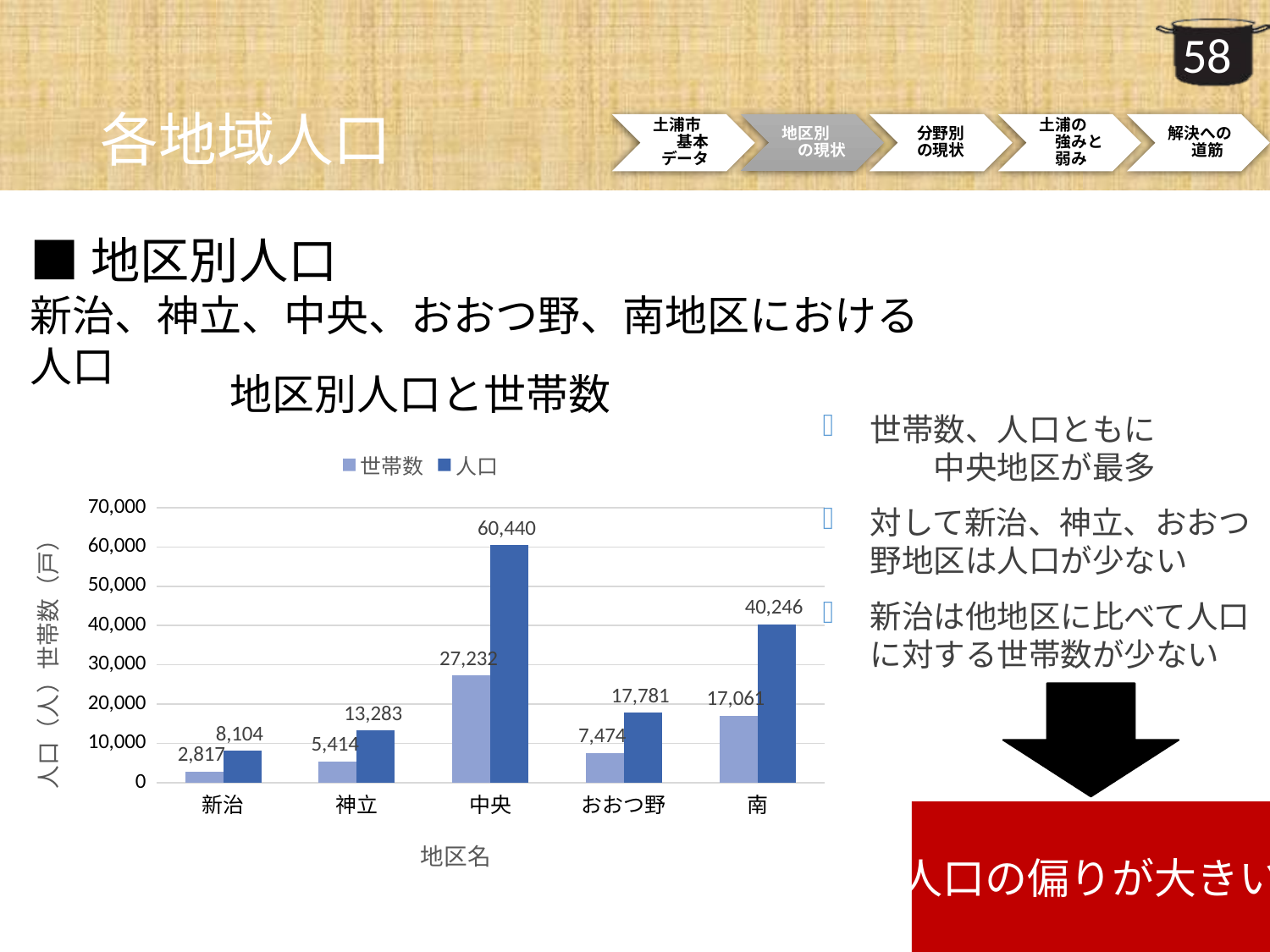
What is the 人口 value for 中央? 60,440 What is the 世帯数 value for 新治? 2,817 Which district has the lowest 世帯数? 新治 How many districts are shown on the x axis? 5 Which is larger, the 世帯数 of 南 or the 人口 of おおつ野? 人口 of おおつ野 Which district has the highest 人口? 中央 What is the 人口 value for 南? 40,246 Is the 世帯数 value for 中央 greater or less than 20,000? greater What type of chart is shown? bar chart How many series does the legend list? 2 What is the 世帯数 value for おおつ野? 7,474 What is the difference between the 人口 of 中央 and the 人口 of 南? 20,194